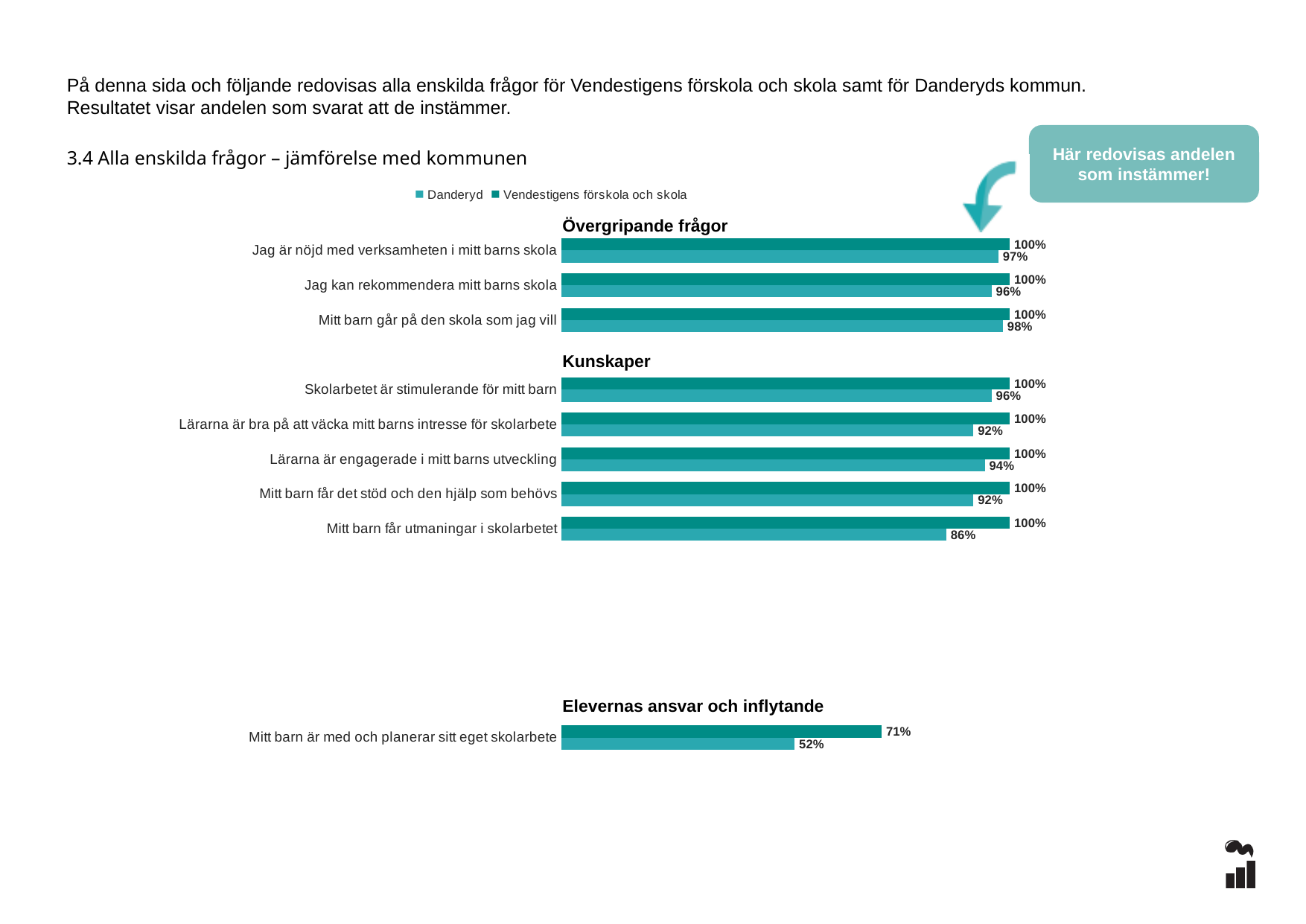
How many questions are listed under the 'Kunskaper' section? 5 What is the value for Danderyd on 'Mitt barn får utmaningar i skolarbetet'? 86% What is the value for Danderyd on 'Mitt barn går på den skola som jag vill'? 98% What is the value for Vendestigens förskola och skola on 'Jag är nöjd med verksamheten i mitt barns skola'? 100% Which question has the lowest value for Danderyd? Mitt barn är med och planerar sitt eget skolarbete What is the difference between Vendestigens förskola och skola and Danderyd on 'Mitt barn är med och planerar sitt eget skolarbete'? 19 percentage points What kind of chart is shown on the slide? bar chart What is the difference between Vendestigens förskola och skola and Danderyd on 'Mitt barn får utmaningar i skolarbetet'? 14 percentage points What is the value for Danderyd on 'Jag kan rekommendera mitt barns skola'? 96% What is the value for Vendestigens förskola och skola on 'Mitt barn är med och planerar sitt eget skolarbete'? 71% Which is larger on 'Lärarna är engagerade i mitt barns utveckling': Vendestigens förskola och skola or Danderyd? Vendestigens förskola och skola How many series does the chart legend list? 2